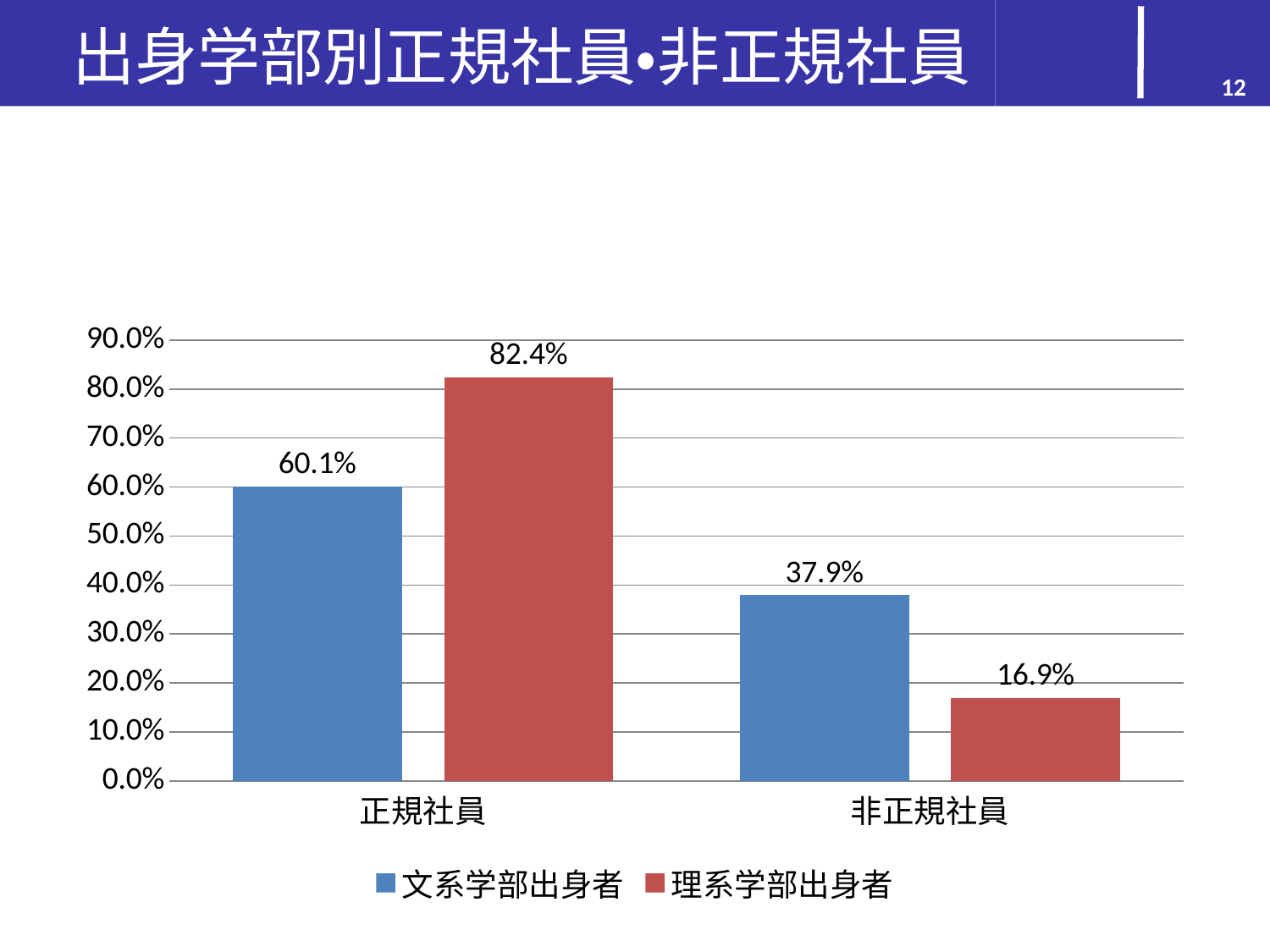
What is the value for 文系学部出身者 in the 正規社員 category? 60.1% Which bar has the lowest value on the chart? 理系学部出身者, 非正規社員 What is the value for 理系学部出身者 in the 正規社員 category? 82.4% What is the difference between 文系学部出身者 and 理系学部出身者 in the 非正規社員 category? 21.0% How many categories are shown on the x axis? 2 How many series does the legend list? 2 What is the difference between 理系学部出身者 and 文系学部出身者 in the 正規社員 category? 22.3% What is the value for 理系学部出身者 in the 非正規社員 category? 16.9% What kind of chart is shown on the slide? Bar chart Which bar has the highest value on the chart? 理系学部出身者, 正規社員 In the 非正規社員 category, which series has the larger value, 文系学部出身者 or 理系学部出身者? 文系学部出身者 What is the value for 文系学部出身者 in the 非正規社員 category? 37.9%